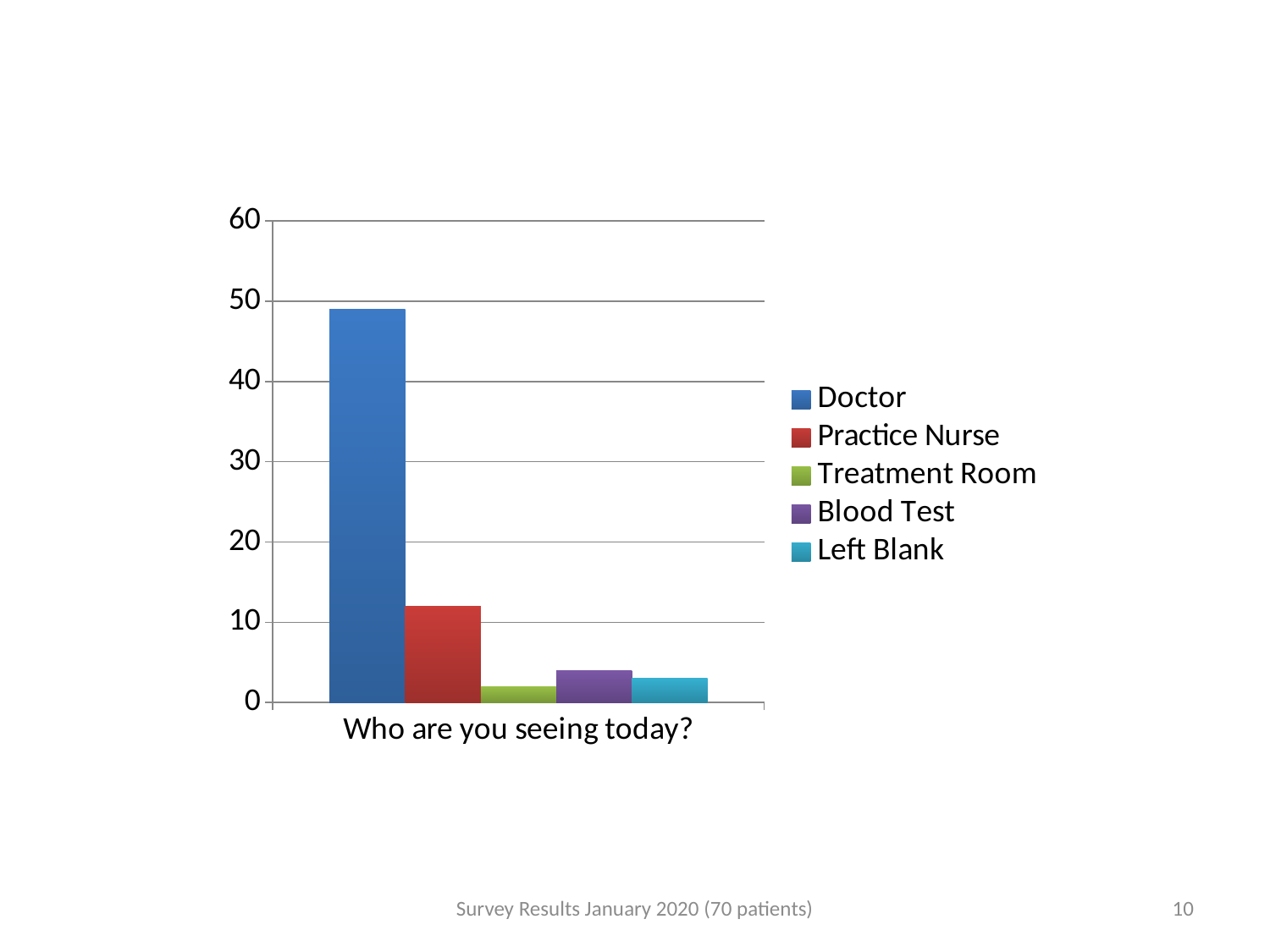
Which is larger, the value for Doctor or the value for Practice Nurse? Doctor How many bars are plotted in the chart? 5 What kind of chart is shown on the slide? bar chart What label appears below the horizontal axis of the chart? Who are you seeing today? Which is larger, the value for Blood Test or the value for Treatment Room? Blood Test Is the value for Practice Nurse greater or less than 10? greater What colour is the Doctor bar in the chart? blue Which series has the highest value? Doctor Is the value for Practice Nurse greater or less than 20? less How many series does the legend list? 5 Is the value for Blood Test greater or less than 10? less